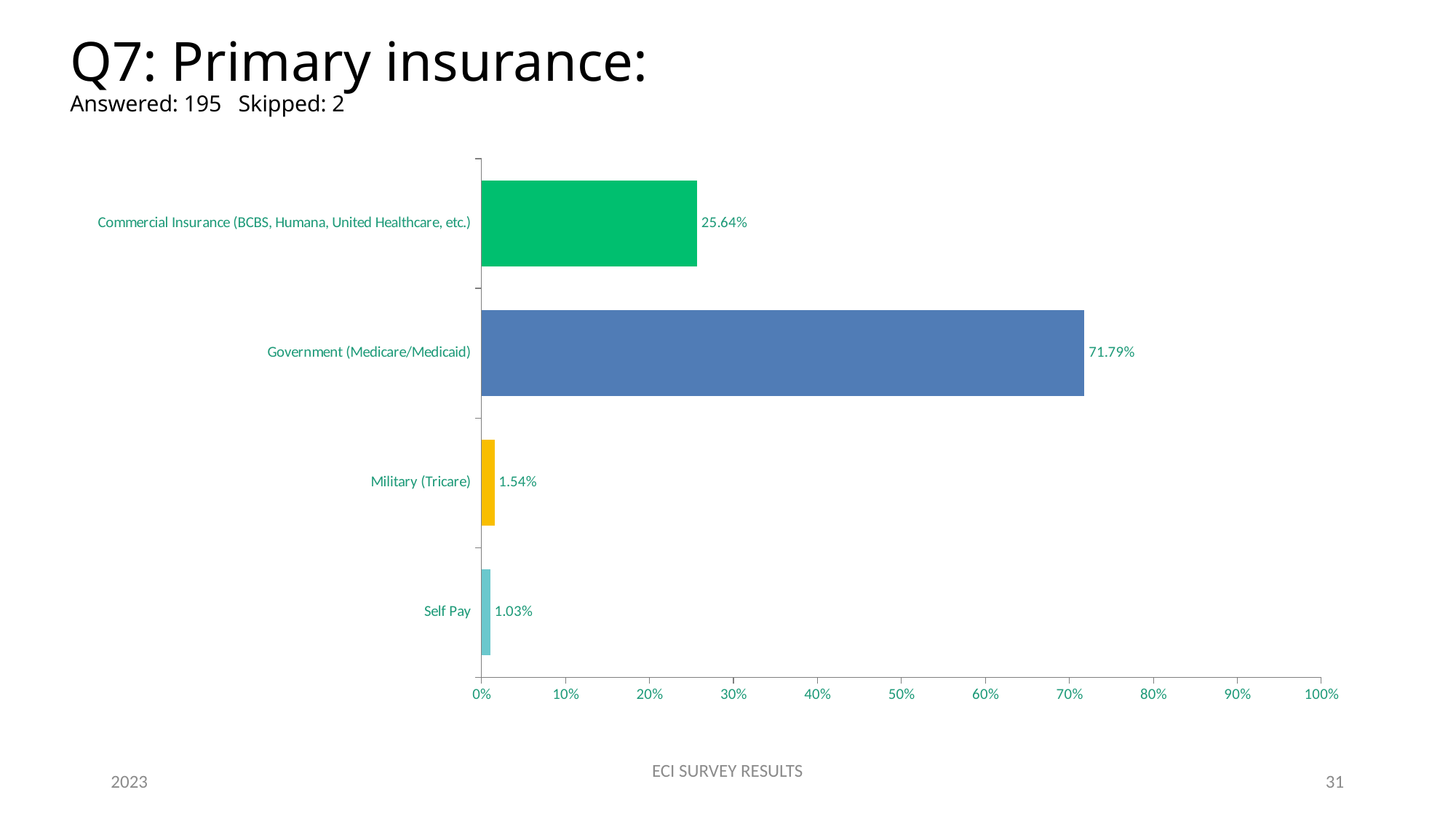
What is the difference in percentage points between Government (Medicare/Medicaid) and Commercial Insurance? 46.15 What is the value for Self Pay? 1.03% What type of chart is used on this slide? Bar chart How many respondents answered this question according to the slide? 195 What percentage of respondents selected Government (Medicare/Medicaid) as their primary insurance? 71.79% Which is larger, the value for Military (Tricare) or the value for Self Pay? Military (Tricare) Is the value for Government (Medicare/Medicaid) greater or less than 60%? greater What is the value shown for Commercial Insurance (BCBS, Humana, United Healthcare, etc.)? 25.64% Which primary insurance category has the lowest percentage? Self Pay What percentage is shown for Military (Tricare)? 1.54% How many primary insurance categories are shown in the chart? 4 Which primary insurance category has the highest percentage? Government (Medicare/Medicaid)